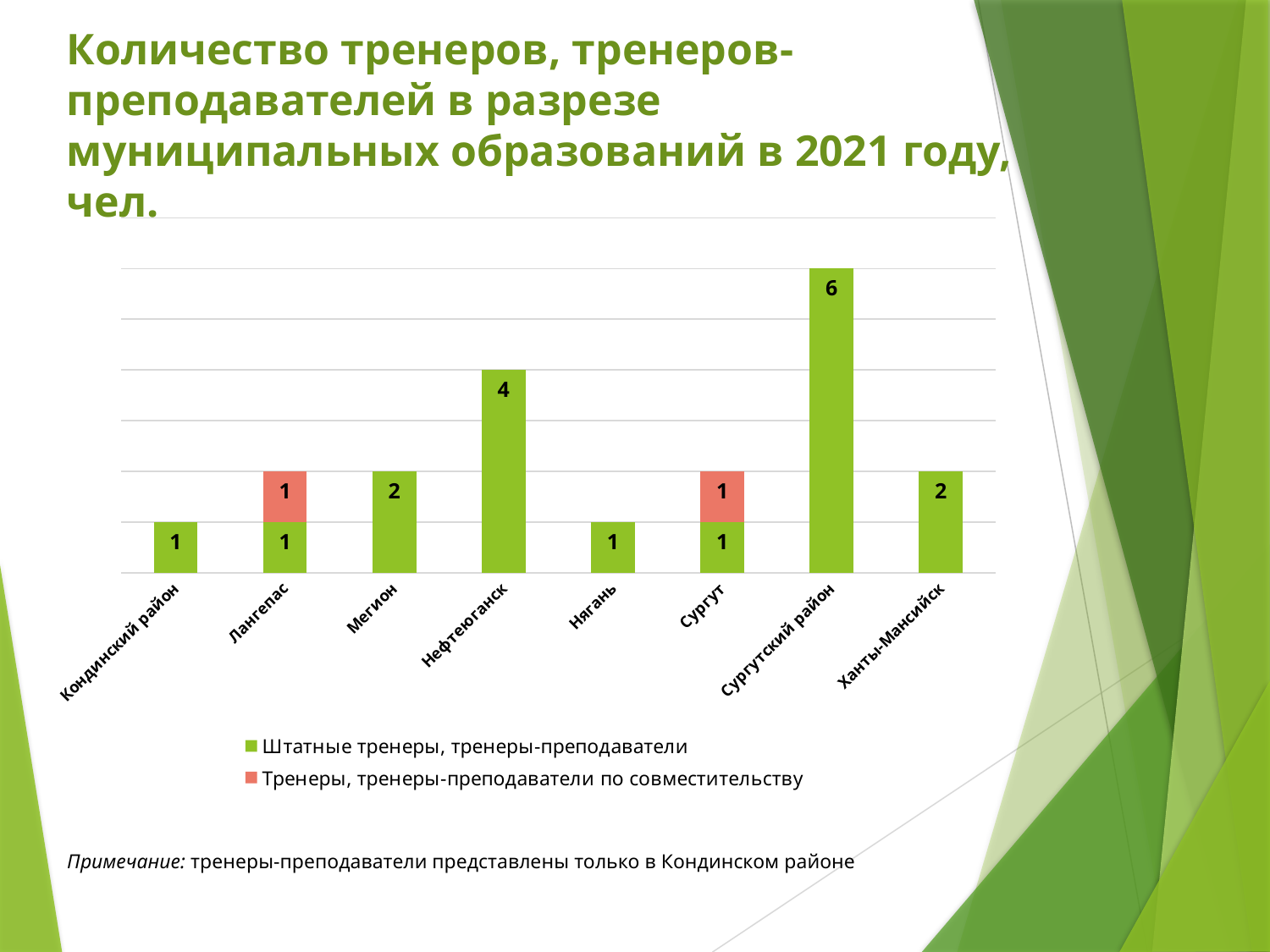
What is the total height of the stacked bar for Сургут? 2 What is the number of Штатные тренеры, тренеры-преподаватели for Сургутский район? 6 How many municipalities are shown on the x axis of the chart? 8 What is the total height of the stacked bar for Лангепас? 2 Which municipality has the highest number of Штатные тренеры, тренеры-преподаватели? Сургутский район What is the number of Штатные тренеры, тренеры-преподаватели for Нефтеюганск? 4 What is the number of Тренеры, тренеры-преподаватели по совместительству for Лангепас? 1 Which municipalities have a bar for Тренеры, тренеры-преподаватели по совместительству? Лангепас and Сургут How many series does the chart legend list? 2 What is the difference between the Штатные тренеры, тренеры-преподаватели values for Сургутский район and Нефтеюганск? 2 Which is larger: the Штатные тренеры, тренеры-преподаватели value for Мегион or for Нягань? Мегион What kind of chart is shown on the slide? stacked bar chart